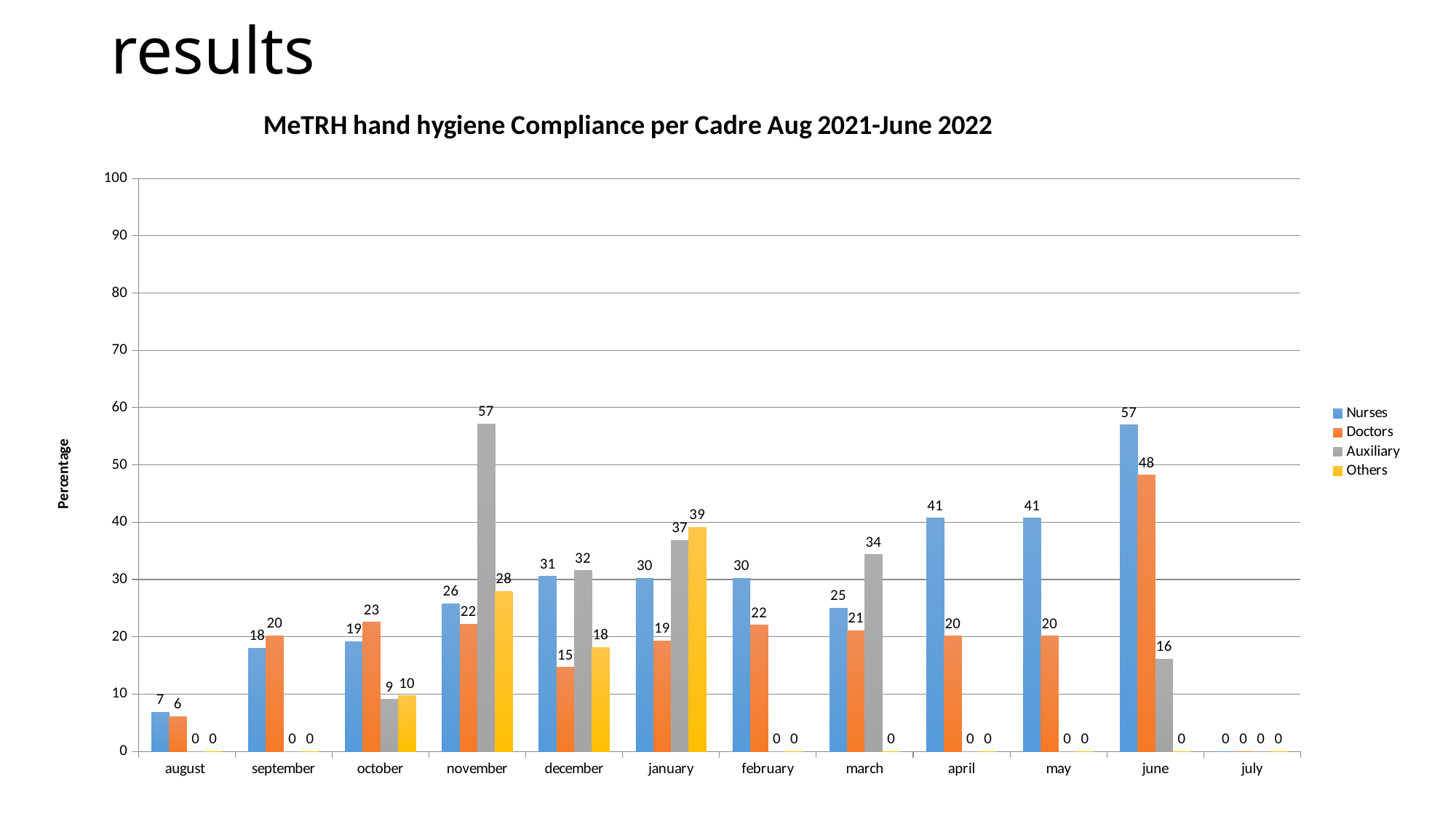
In which month is the Nurses value highest? june How many months are shown on the x axis? 12 What is the title of the chart? MeTRH hand hygiene Compliance per Cadre Aug 2021-June 2022 What is the value for Others in january? 39 Which is larger in december, the Nurses value or the Auxiliary value? Auxiliary What is the difference between the Nurses and Doctors values in june? 9 What kind of chart is shown on the slide? bar chart How many series does the legend list? 4 What is the value for Nurses in june? 57 What is the value for Doctors in october? 23 What is the value for Auxiliary in november? 57 Excluding months where it is 0, in which month is the Doctors value lowest? august